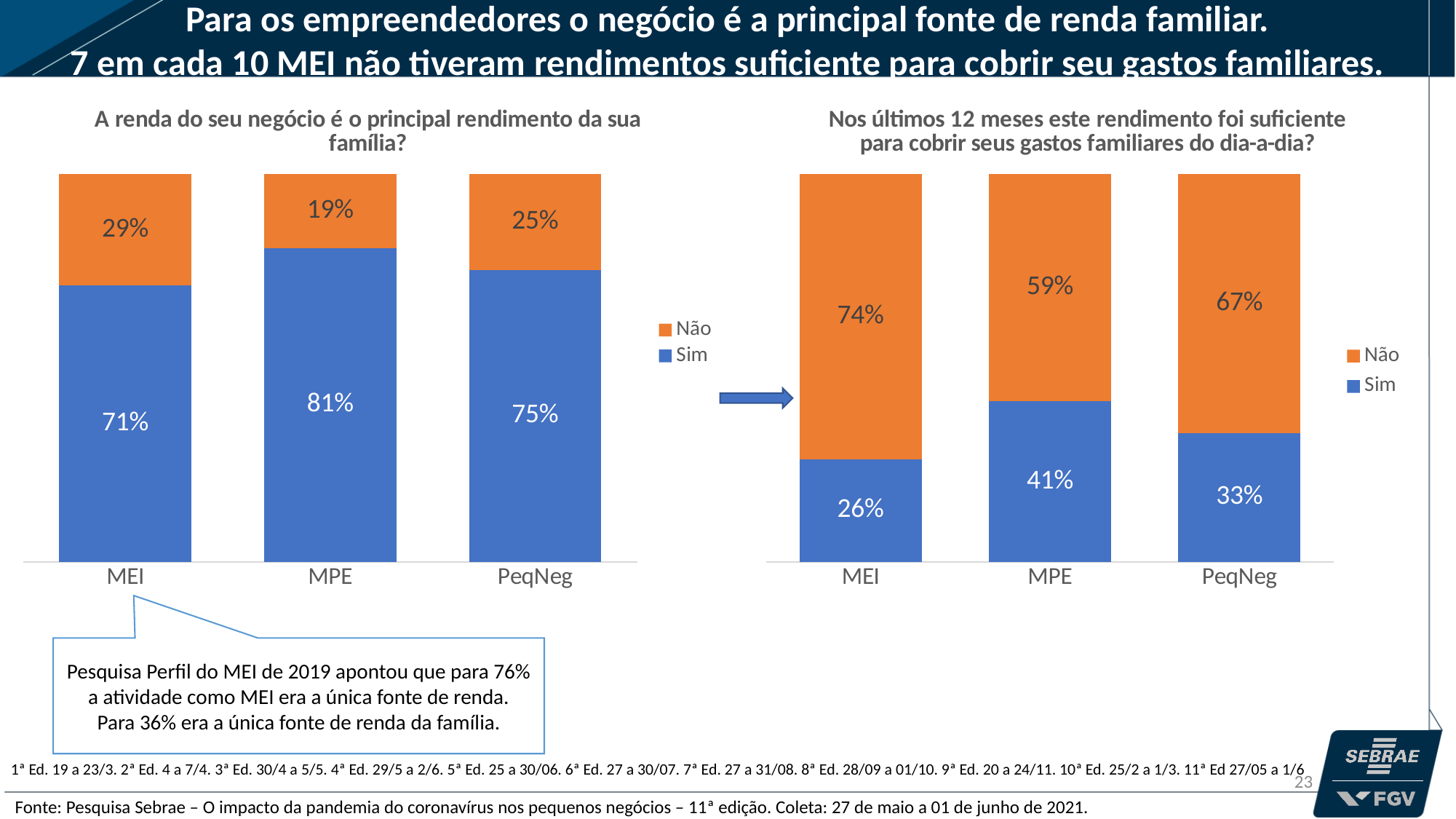
What type of chart is the right chart ('Nos últimos 12 meses este rendimento foi suficiente...')? Stacked bar chart In the right chart ('Nos últimos 12 meses este rendimento foi suficiente...'), which colour represents 'Não'? Orange In the right chart ('Nos últimos 12 meses este rendimento foi suficiente...'), what is the 'Sim' value for PeqNeg? 33% In the left chart ('A renda do seu negócio é o principal rendimento da sua família?'), what is the 'Não' value for MPE? 19% In the right chart ('Nos últimos 12 meses este rendimento foi suficiente...'), which category has the lowest 'Sim' value? MEI In the right chart ('Nos últimos 12 meses este rendimento foi suficiente...'), what is the difference between the 'Não' values for MEI and MPE? 15% In the left chart ('A renda do seu negócio é o principal rendimento da sua família?'), is the 'Sim' value for PeqNeg larger or smaller than the 'Sim' value for MEI? larger In the left chart ('A renda do seu negócio é o principal rendimento da sua família?'), what is the 'Sim' value for MEI? 71% How many series does the legend of the left chart ('A renda do seu negócio é o principal rendimento da sua família?') list? 2 In the right chart ('Nos últimos 12 meses este rendimento foi suficiente...'), what is the 'Não' value for MEI? 74% In the left chart ('A renda do seu negócio é o principal rendimento da sua família?'), which category has the highest 'Sim' value? MPE How many categories are shown on the x axis of the right chart ('Nos últimos 12 meses este rendimento foi suficiente...')? 3